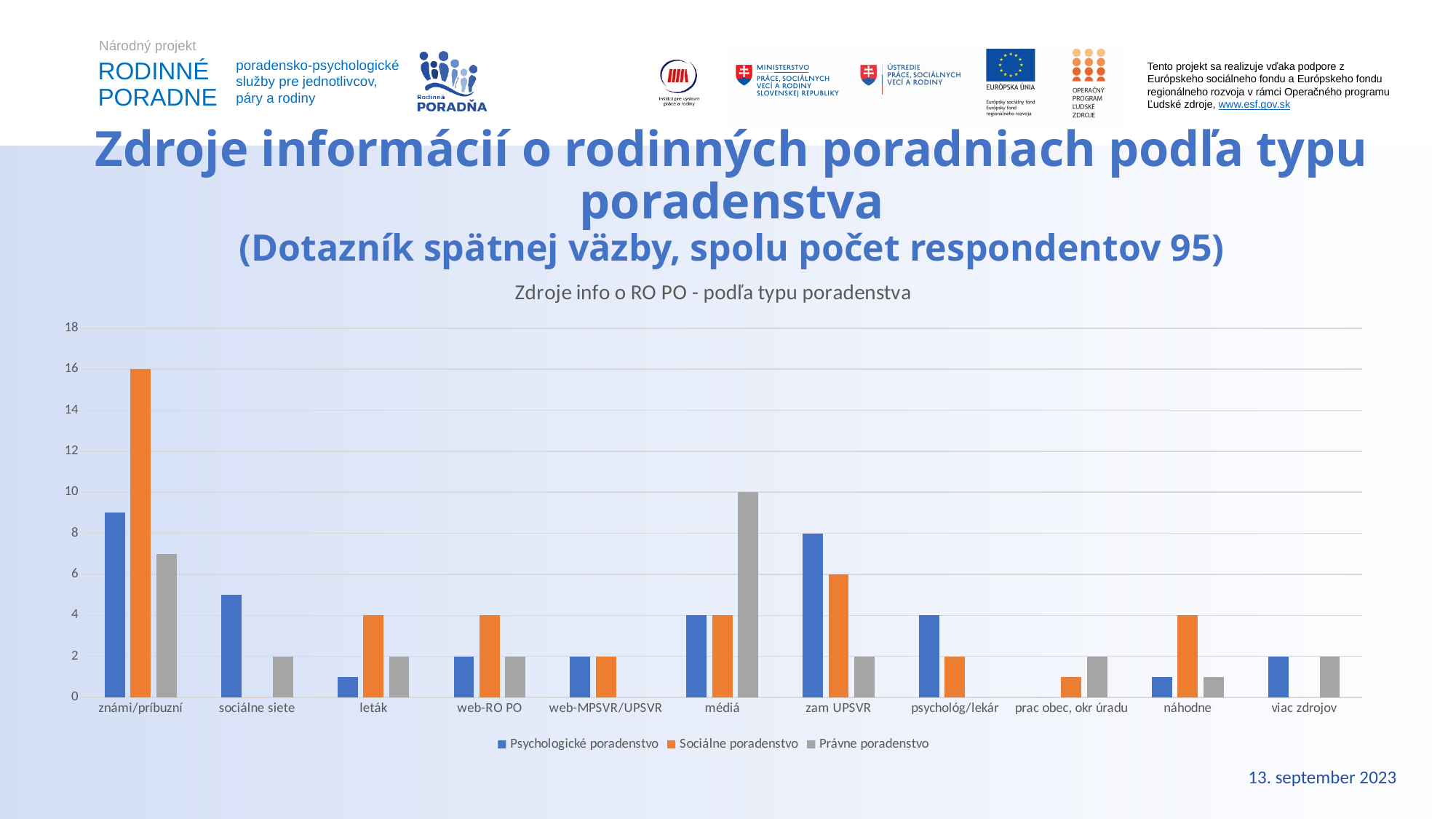
What is the value of Právne poradenstvo for médiá? 10 What is the value of Psychologické poradenstvo for zam UPSVR? 8 How many categories are shown on the x axis? 11 Which category has the highest value for Sociálne poradenstvo? známi/príbuzní For médiá, which is larger: Právne poradenstvo or Psychologické poradenstvo? Právne poradenstvo Is the value of Psychologické poradenstvo for známi/príbuzní greater or less than 8? greater What is the title of the chart? Zdroje info o RO PO - podľa typu poradenstva For zam UPSVR, what is the difference between Sociálne poradenstvo and Právne poradenstvo? 4 What is the value of Sociálne poradenstvo for známi/príbuzní? 16 How many series does the legend list? 3 Is the value of Psychologické poradenstvo for sociálne siete greater or less than 4? greater What type of chart is shown on the slide? bar chart